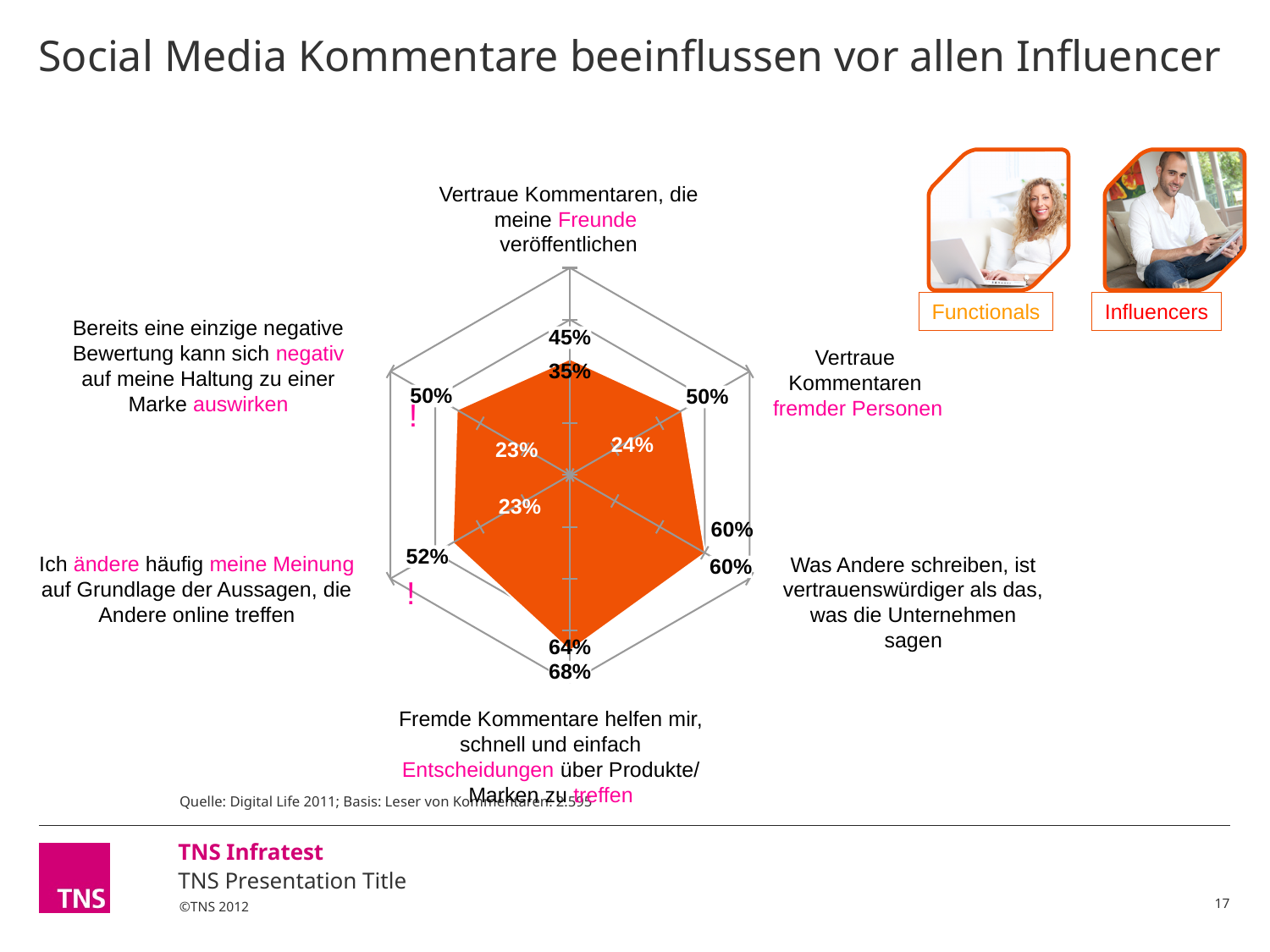
On which axis of the radar chart does the highest printed value (68%) appear? Fremde Kommentare helfen mir, schnell und einfach Entscheidungen über Produkte/Marken zu treffen What is the difference between the two values printed on the axis 'Vertraue Kommentaren, die meine Freunde veröffentlichen' (45% and 35%)? 10 percentage points What is the highest value printed on the radar chart? 68% What is the difference between the two values printed on the axis 'Vertraue Kommentaren fremder Personen' (50% and 24%)? 26 percentage points What type of chart is shown on the slide? Radar chart How many axes (categories) does the radar chart have? 6 What two values are printed on the axis 'Was Andere schreiben, ist vertrauenswürdiger als das, was die Unternehmen sagen'? 60% and 60% What is the lowest value printed on the radar chart? 23% What two values are printed on the axis 'Vertraue Kommentaren fremder Personen'? 50% and 24% Of the two values printed on the axis 'Ich ändere häufig meine Meinung auf Grundlage der Aussagen, die Andere online treffen', which is larger? 52%